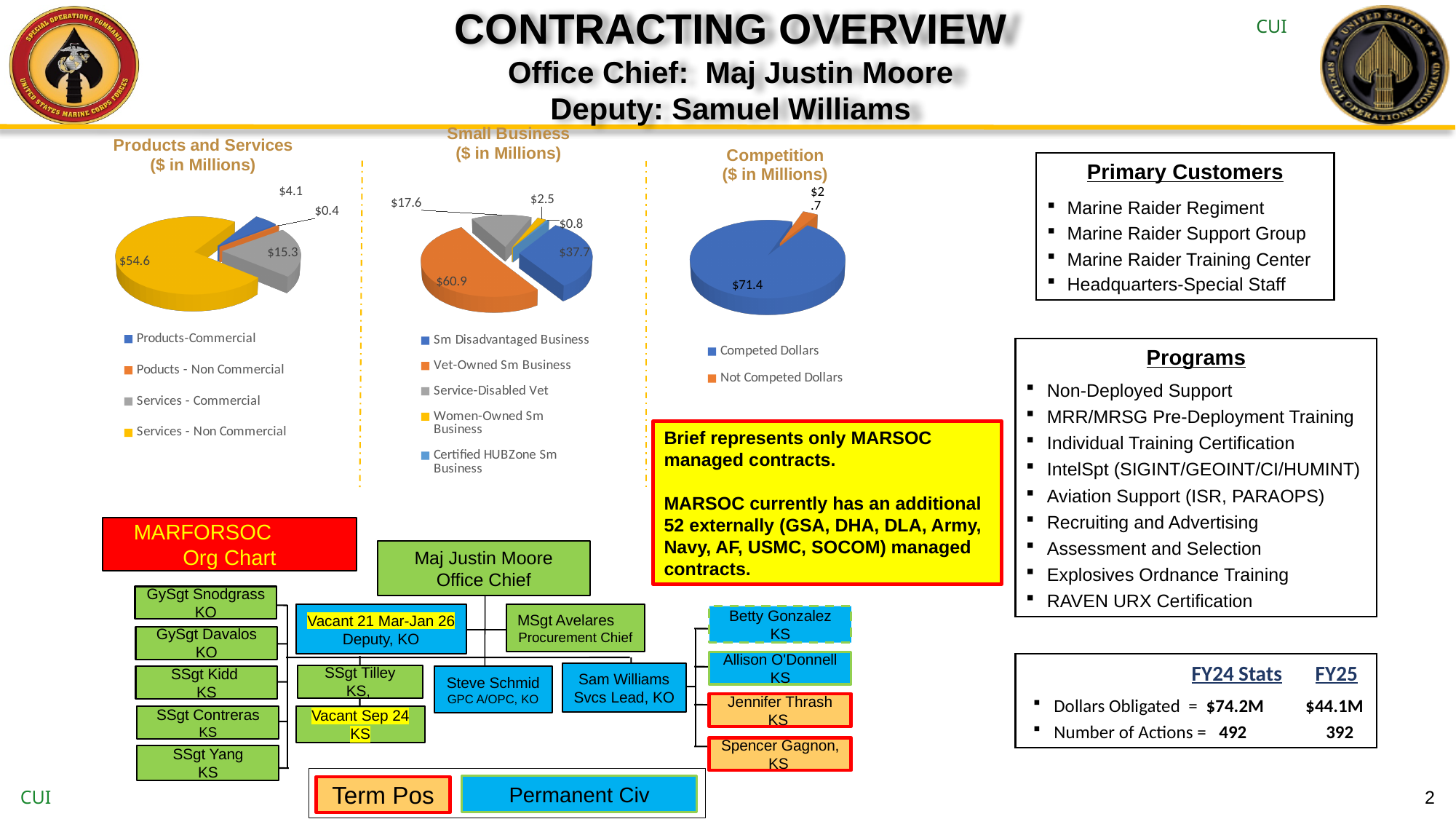
What type of chart is the Competition chart? Pie chart In the Competition chart, what is the value for Not Competed Dollars? $2.7 In the Products and Services chart, what is the value for Services - Non Commercial? $54.6 In the Small Business chart, which is larger: Sm Disadvantaged Business or Service-Disabled Vet? Sm Disadvantaged Business In the Products and Services chart, what is the value for Products-Commercial? $4.1 In the Small Business chart, what is the value for Vet-Owned Sm Business? $60.9 In the Small Business chart, how many categories does the legend list? 5 In the Products and Services chart, what is the difference between Services - Non Commercial and Services - Commercial? $39.3 In the Competition chart, what is the difference between Competed Dollars and Not Competed Dollars? $68.7 In the Small Business chart, which category has the largest value? Vet-Owned Sm Business In the Small Business chart, what is the value for Certified HUBZone Sm Business? $0.8 In the Products and Services chart, which category has the smallest value? Poducts - Non Commercial